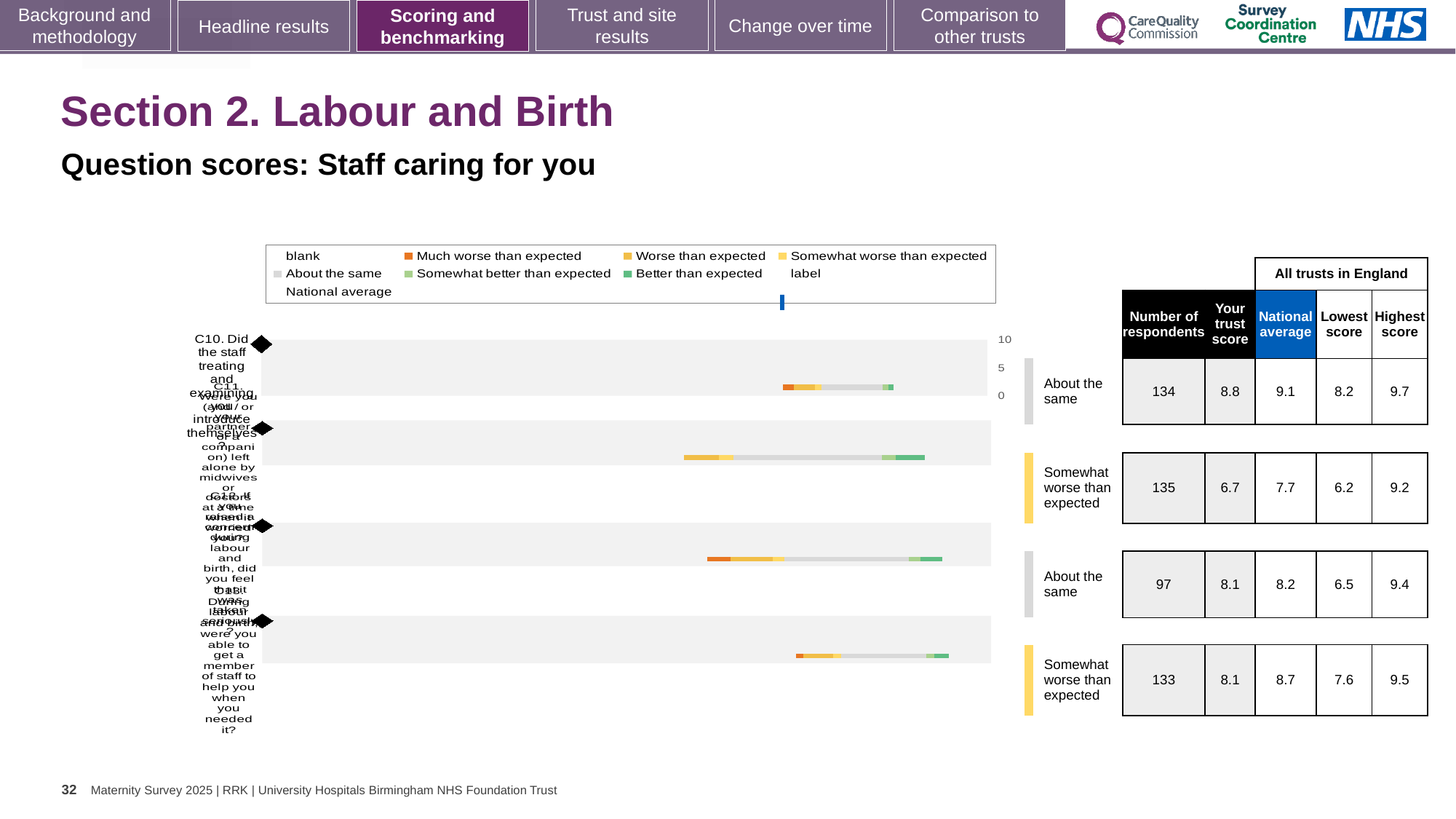
What is the trust score for the first question (C10) in the table next to the chart? 8.8 Which question has the lowest trust score? C11 How many respondents answered the third question (C12)? 97 What is the lowest score among all trusts in England for the third question (C12)? 6.5 Is the trust score for the first question (C10) larger or smaller than its national average? smaller What kind of chart is shown on the slide? bar chart Which question has the highest trust score? C10 What is the highest score among all trusts in England for the fourth question (C13)? 9.5 What is the national average for the second question (C11)? 7.7 What is the difference between the national average and the trust score for the second question (C11)? 1.0 How many questions (bars) are plotted in the chart? 4 What benchmark category is shown for the second question (C11)? Somewhat worse than expected